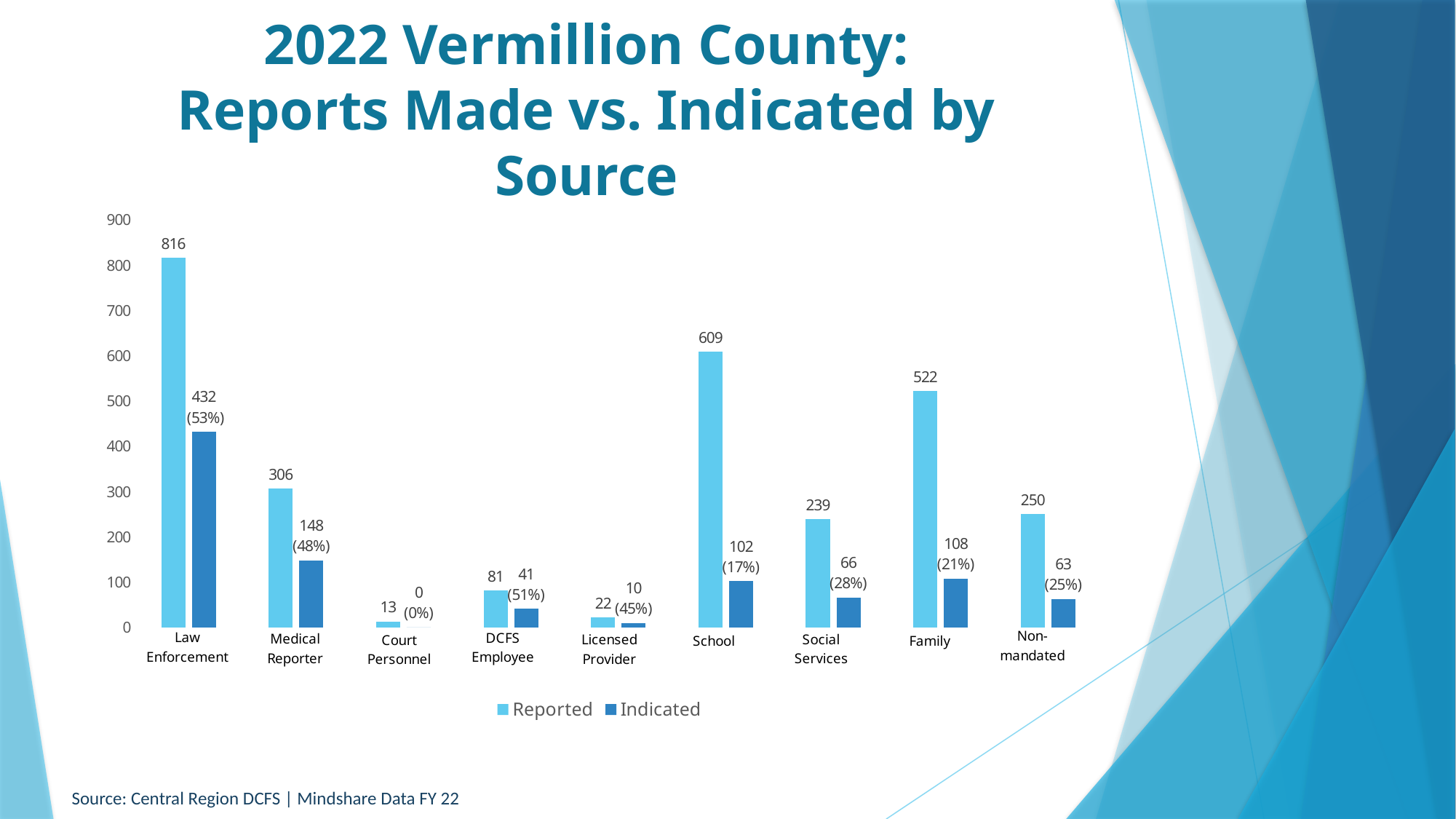
What percentage is shown next to the Indicated value for Non-mandated? 25% Which is larger, the Reported value for School or the Reported value for Family? School How many series does the legend list? 2 Which source has the lowest Indicated value? Court Personnel What is the Reported value for Social Services? 239 What is the difference between the Reported and Indicated values for Family? 414 What is the Indicated value for School? 102 Which source has the highest Reported value? Law Enforcement What is the Reported value for Law Enforcement? 816 How many source categories are shown on the x axis? 9 Is the Reported value for Medical Reporter greater or less than 400? less What kind of chart is shown on the slide? bar chart